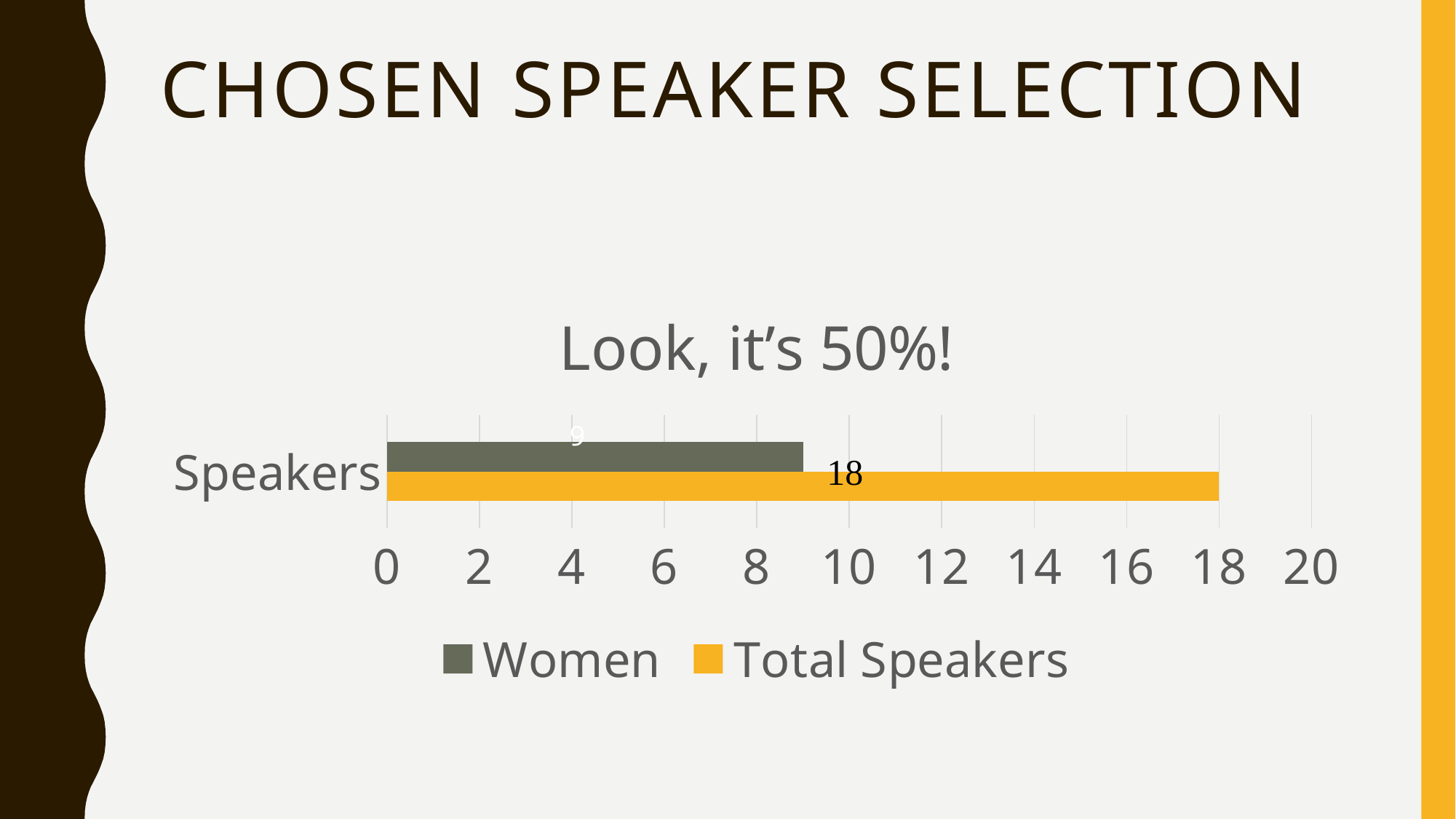
Is the value for Women greater or less than 10? less What is the value for Women in the Speakers category? 9 Is the value for Total Speakers greater or less than 16? greater Which series is shown in yellow? Total Speakers What is the title of the chart? Look, it's 50%! Which series has the larger value for Speakers, Women or Total Speakers? Total Speakers What is the maximum value shown on the x axis? 20 What is the difference between the Total Speakers value and the Women value? 9 How many series does the legend list? 2 What kind of chart is shown on the slide? Bar chart How many categories are shown on the chart? 1 What is the value for Total Speakers in the Speakers category? 18